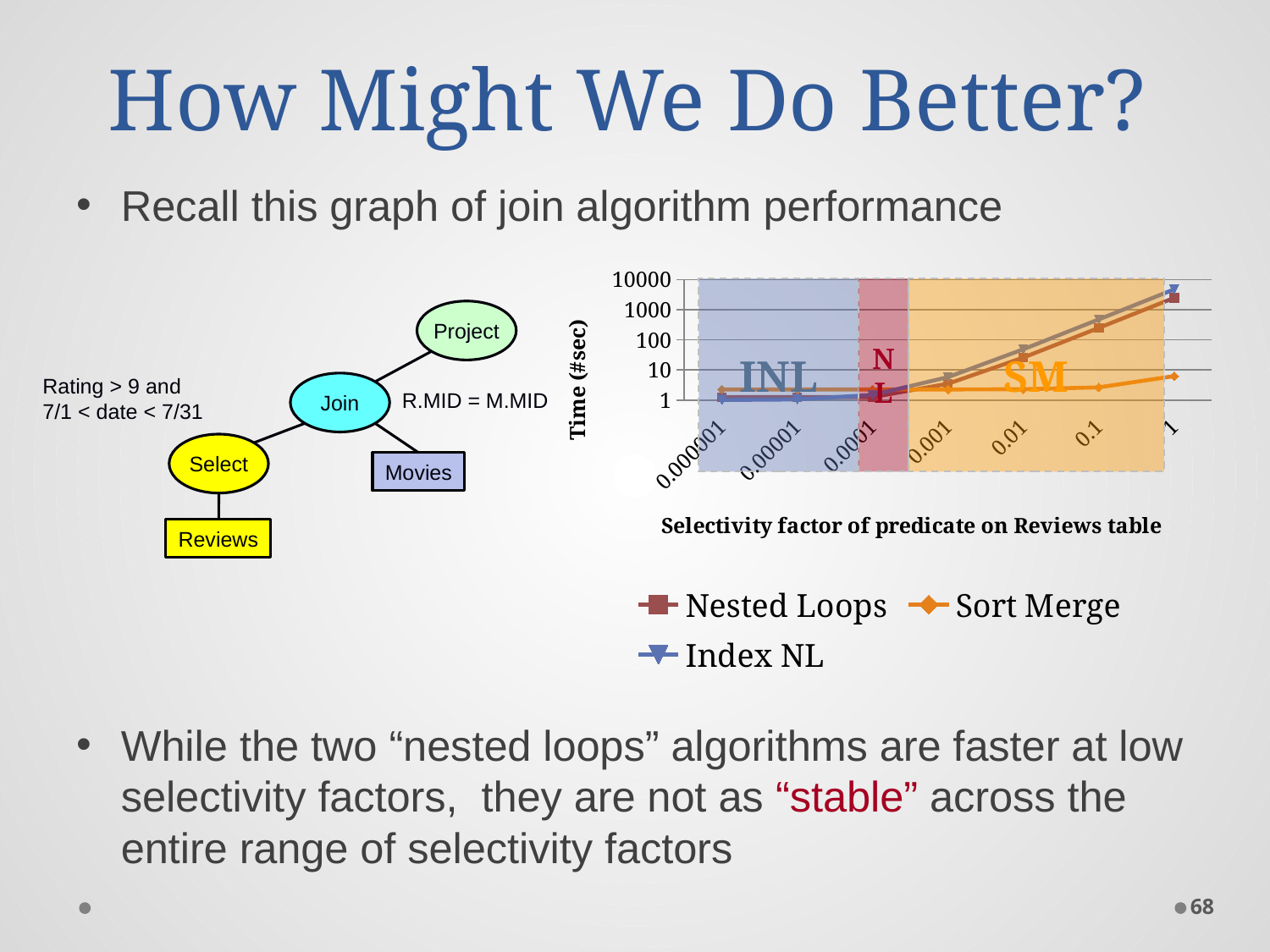
What is the title of the x axis of the chart? Selectivity factor of predicate on Reviews table What is the title of the y axis of the chart? Time (#sec) How many series does the chart's legend list? 3 How many selectivity factor values are marked along the x axis of the chart? 7 Is the time for Nested Loops at a selectivity factor of 0.1 greater or less than 100? greater Is the time for Nested Loops at a selectivity factor of 1 greater or less than 1000? greater Which series has the lowest time at a selectivity factor of 1? Sort Merge Is the time for Index NL at a selectivity factor of 0.01 greater or less than 10? greater What kind of chart is shown on the slide? line chart At a selectivity factor of 0.1, which series has the higher time, Index NL or Sort Merge? Index NL Does the time for Nested Loops rise or fall as the selectivity factor increases from 0.001 to 1? rise